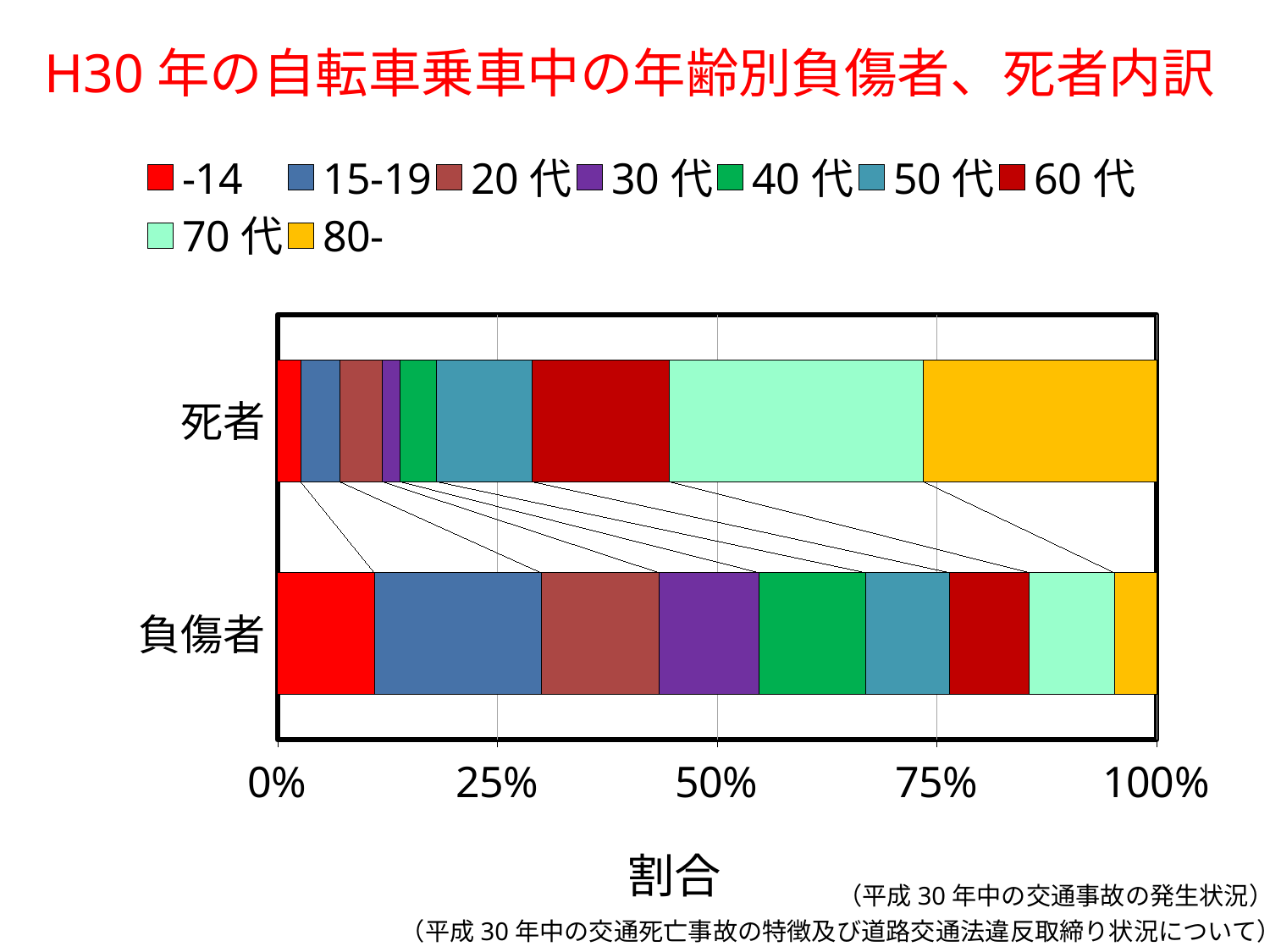
What value does each stacked bar reach on the horizontal axis? 100% In the 負傷者 bar, which age group has the largest share? 15-19 What kind of chart is shown on the slide? Stacked bar chart Which bar has the larger share for -14, 死者 or 負傷者? 負傷者 Which bar has the larger share for 80-, 死者 or 負傷者? 死者 How many categories (bars) does the chart show? 2 What is the label of the horizontal axis? 割合 In the 負傷者 bar, is the share for -14 greater or less than 25%? less In the 死者 bar, is the share for 60代 greater or less than 25%? less How many series does the legend list? 9 What is the title of the chart on the slide? H30年の自転車乗車中の年齢別負傷者、死者内訳 In the 死者 bar, is the share for 70代 greater or less than 25%? greater